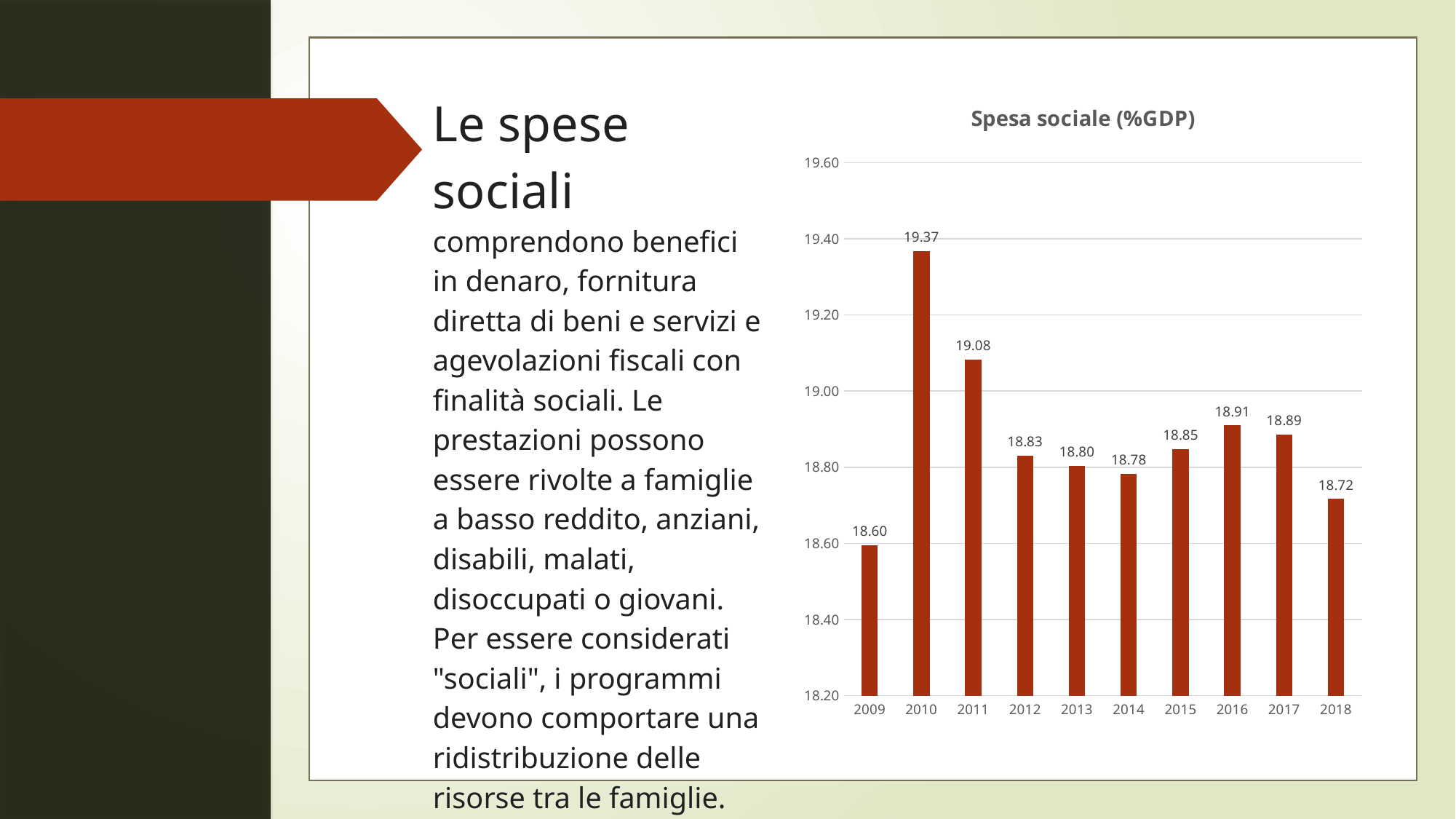
How many years are shown on the x axis of the Spesa sociale (%GDP) chart? 10 What is the difference between the values for 2017 and 2018 in the Spesa sociale (%GDP) chart? 0.17 What is the value for 2010 in the Spesa sociale (%GDP) chart? 19.37 What kind of chart is the Spesa sociale (%GDP) chart? bar chart Which is larger in the Spesa sociale (%GDP) chart, the value for 2011 or the value for 2016? 2011 Which year has the lowest value in the Spesa sociale (%GDP) chart? 2009 What is the title of the chart on the slide? Spesa sociale (%GDP) What is the value for 2018 in the Spesa sociale (%GDP) chart? 18.72 Is the value for 2012 in the Spesa sociale (%GDP) chart greater or less than 19.00? less Which year has the highest value in the Spesa sociale (%GDP) chart? 2010 What is the value for 2014 in the Spesa sociale (%GDP) chart? 18.78 What is the difference between the values for 2010 and 2011 in the Spesa sociale (%GDP) chart? 0.29